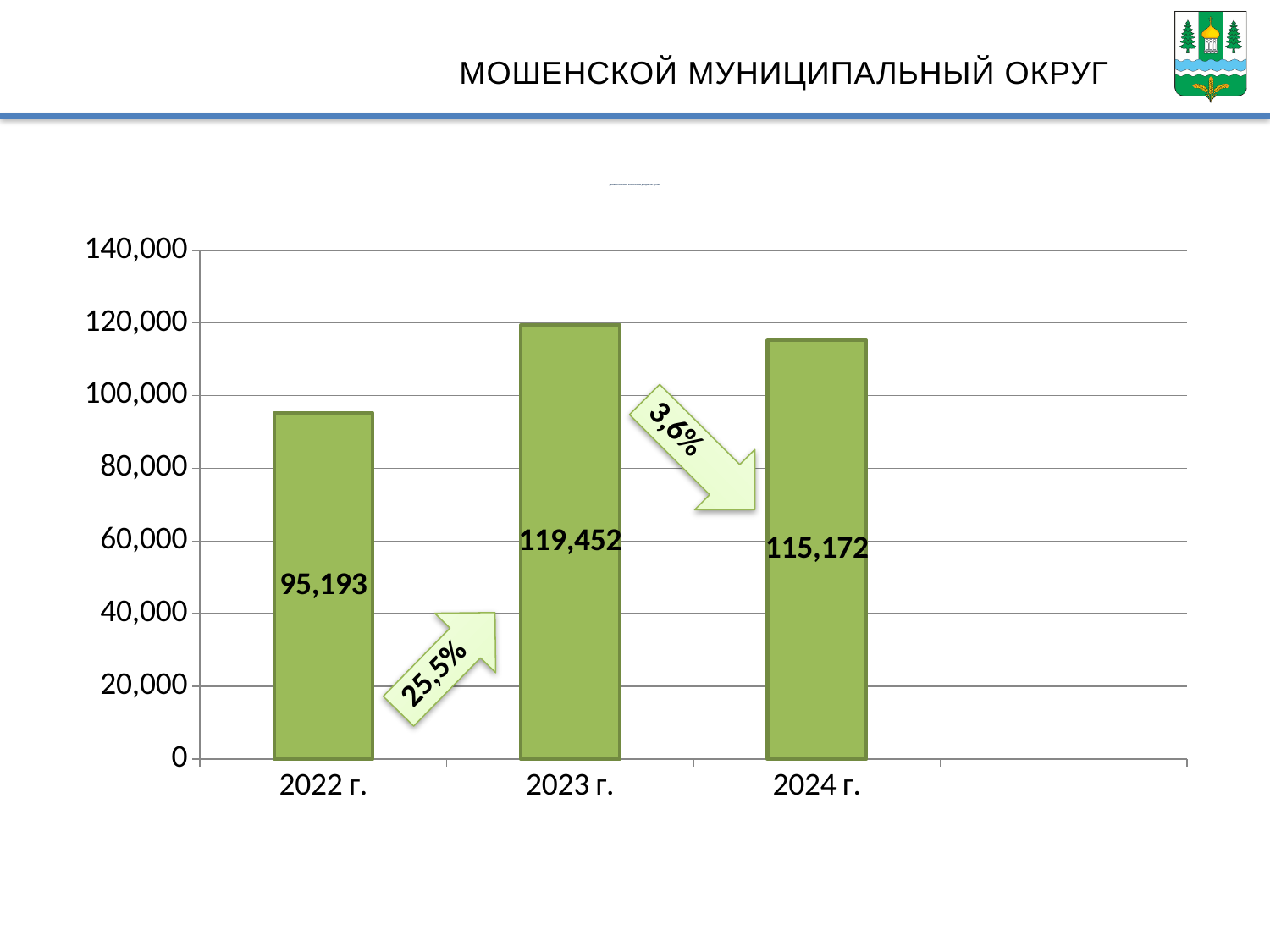
What is the value for 2023 г.? 119,452 What kind of chart is shown on the slide? bar chart What is the difference between the values for 2023 г. and 2024 г.? 4,280 What percentage change is shown on the arrow between 2022 г. and 2023 г.? 25,5% How many years are shown on the chart? 3 Which year has the lowest value? 2022 г. Is the value for 2022 г. greater or less than 100,000? less Which is larger, the value for 2024 г. or the value for 2022 г.? 2024 г. Which year has the highest value? 2023 г. What is the value for 2024 г.? 115,172 What is the difference between the values for 2023 г. and 2022 г.? 24,259 What is the value for 2022 г.? 95,193